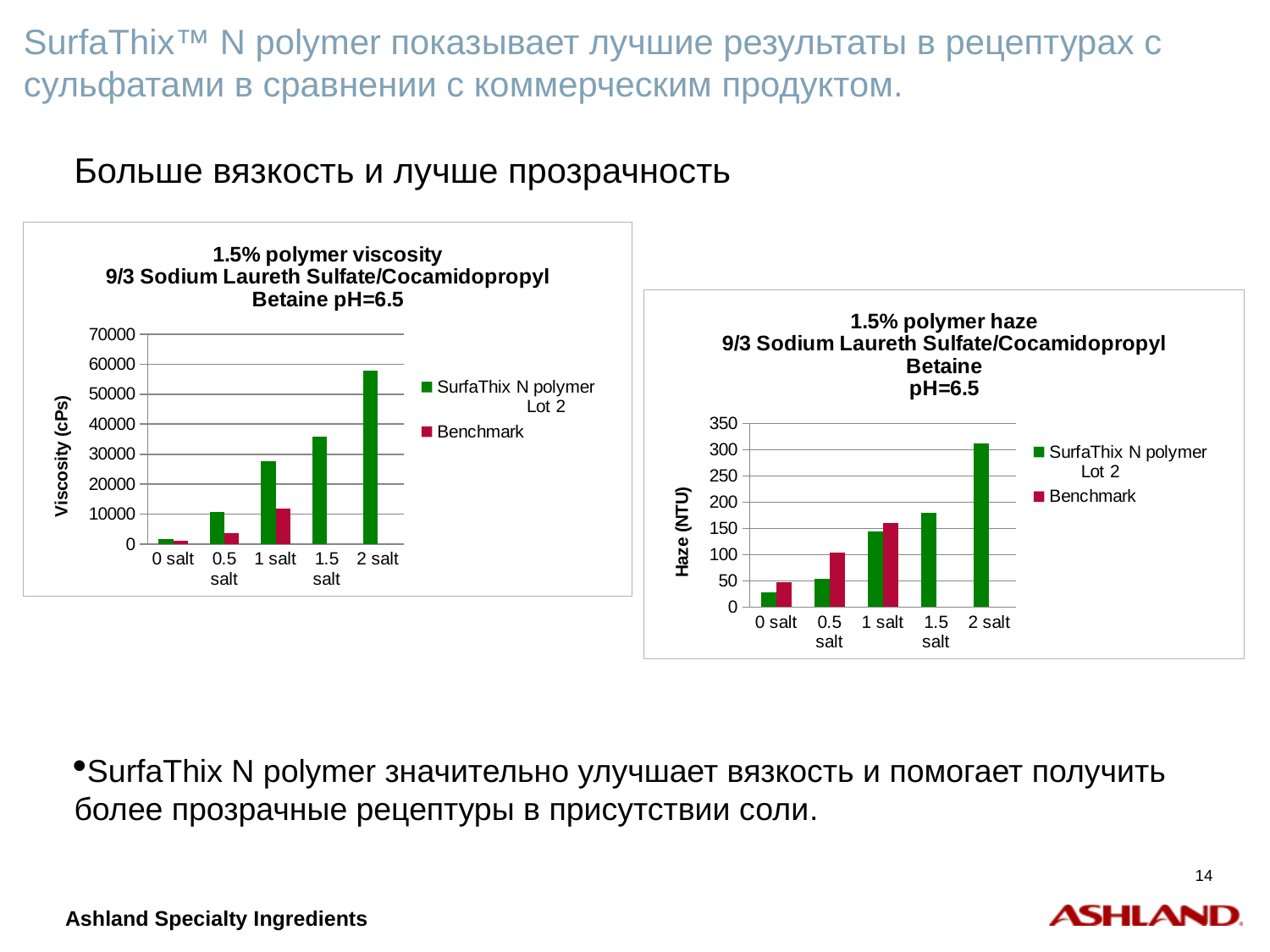
In the '1.5% polymer viscosity' chart, is the Benchmark value at 1 salt greater or less than 20000? less In the '1.5% polymer viscosity' chart, is the SurfaThix N polymer Lot 2 value at 2 salt greater or less than 50000? greater In the '1.5% polymer viscosity' chart, how many salt-level categories are on the x axis? 5 In the '1.5% polymer viscosity' chart, do the SurfaThix N polymer Lot 2 values rise or fall as the salt level increases? rise In the '1.5% polymer viscosity' chart, how many series does the legend list? 2 In the '1.5% polymer viscosity' chart, what kind of chart is shown? bar chart In the '1.5% polymer viscosity' chart, at which salt level is the SurfaThix N polymer Lot 2 viscosity highest? 2 salt In the '1.5% polymer haze' chart, at 0.5 salt, which series has the larger haze? Benchmark In the '1.5% polymer viscosity' chart, at 1 salt, which series has the larger viscosity? SurfaThix N polymer Lot 2 In the '1.5% polymer haze' chart, is the SurfaThix N polymer Lot 2 value at 2 salt greater or less than 250? greater In the '1.5% polymer haze' chart, what is the label of the y axis? Haze (NTU) In the '1.5% polymer haze' chart, at which salt level is the SurfaThix N polymer Lot 2 haze highest? 2 salt